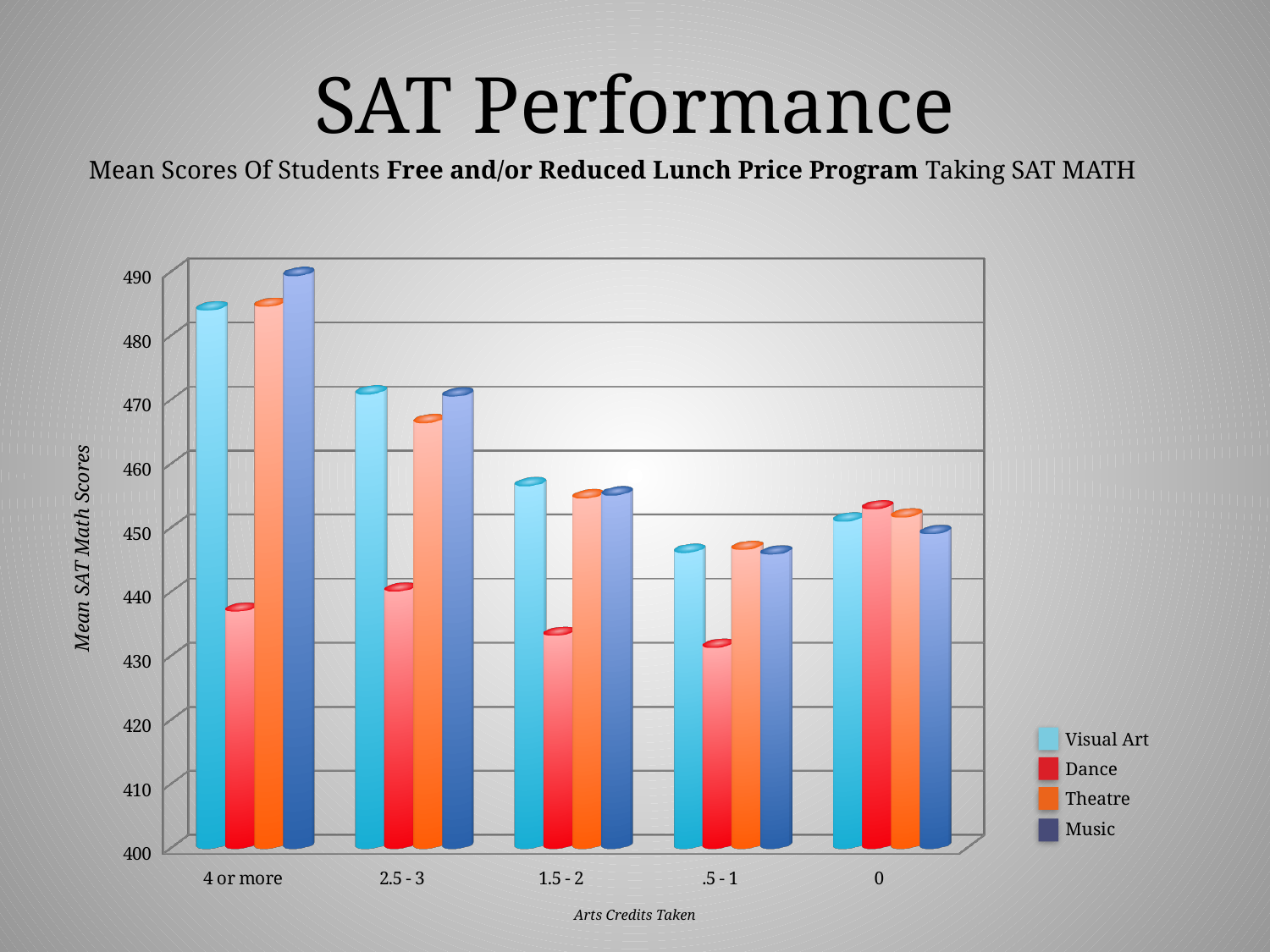
Is the Visual Art value for '2.5 - 3' greater or less than 460? greater Does the Visual Art score rise or fall from '4 or more' to '.5 - 1' along the x axis? fall Which Arts Credits Taken category has the lowest Dance score? .5 - 1 What is the title of the x axis? Arts Credits Taken For the '4 or more' category, which is larger, Music or Dance? Music What kind of chart is shown on the slide? bar chart Is the Music value for '4 or more' greater or less than 480? greater How many categories of Arts Credits Taken are shown on the x axis? 5 How many series does the legend list? 4 For the '1.5 - 2' category, which is larger, Dance or Theatre? Theatre Which Arts Credits Taken category has the highest Music score? 4 or more Is the Dance value for '4 or more' greater or less than 450? less